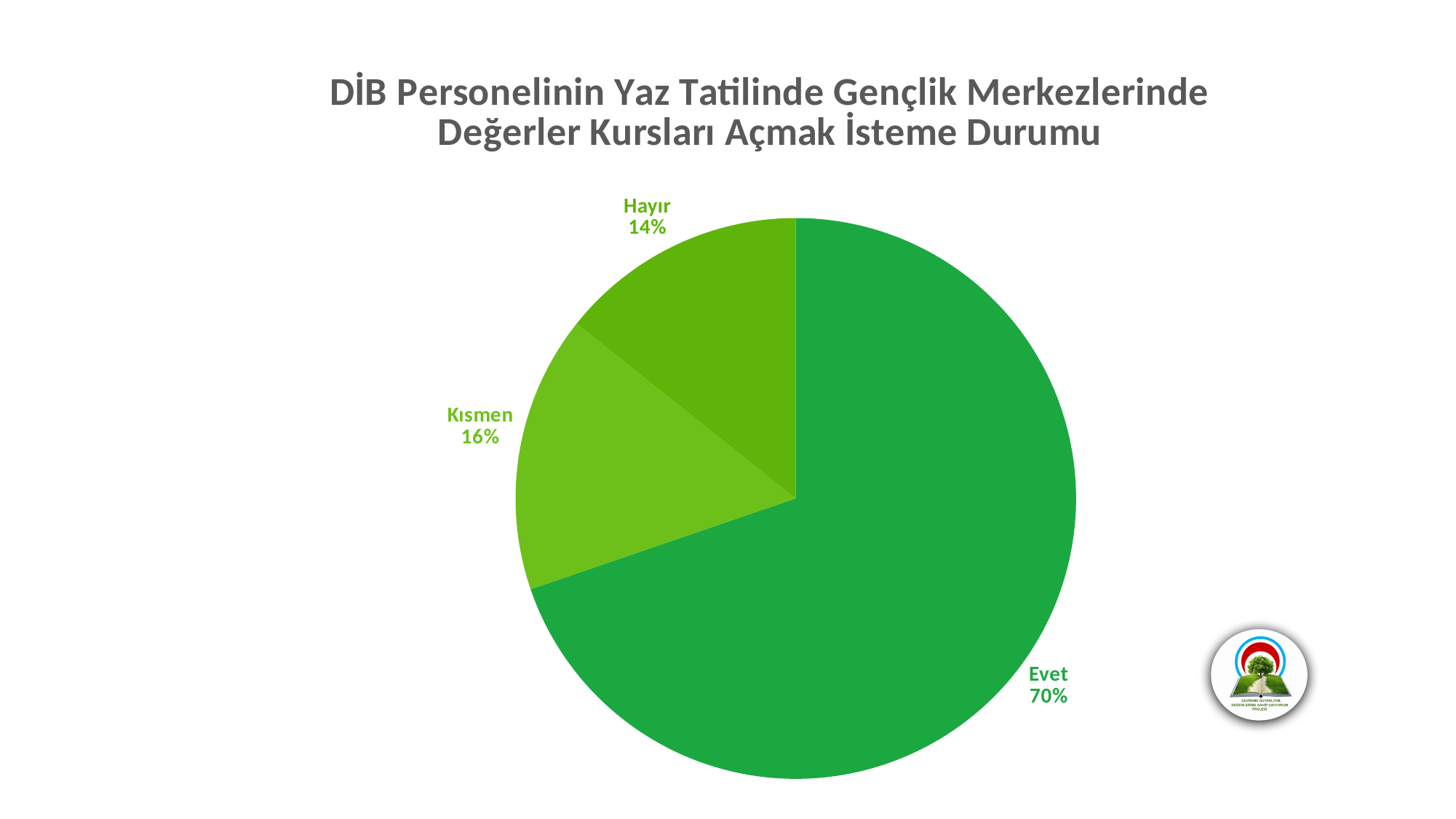
Which category has the largest slice of the pie? Evet What is the difference in percentage points between the Evet and Kısmen slices? 54 What share of the pie do Kısmen and Hayır make up together? 30% How many slices does the pie chart have? 3 What is the difference in percentage points between the Kısmen and Hayır slices? 2 Which slice is larger, Kısmen or Hayır? Kısmen Which category has the smallest slice of the pie? Hayır What percentage of the pie is labelled Hayır? 14% What percentage of the pie is labelled Evet? 70% What kind of chart is shown on the slide? pie chart What percentage of the pie is labelled Kısmen? 16% What is the title of the chart? DİB Personelinin Yaz Tatilinde Gençlik Merkezlerinde Değerler Kursları Açmak İsteme Durumu